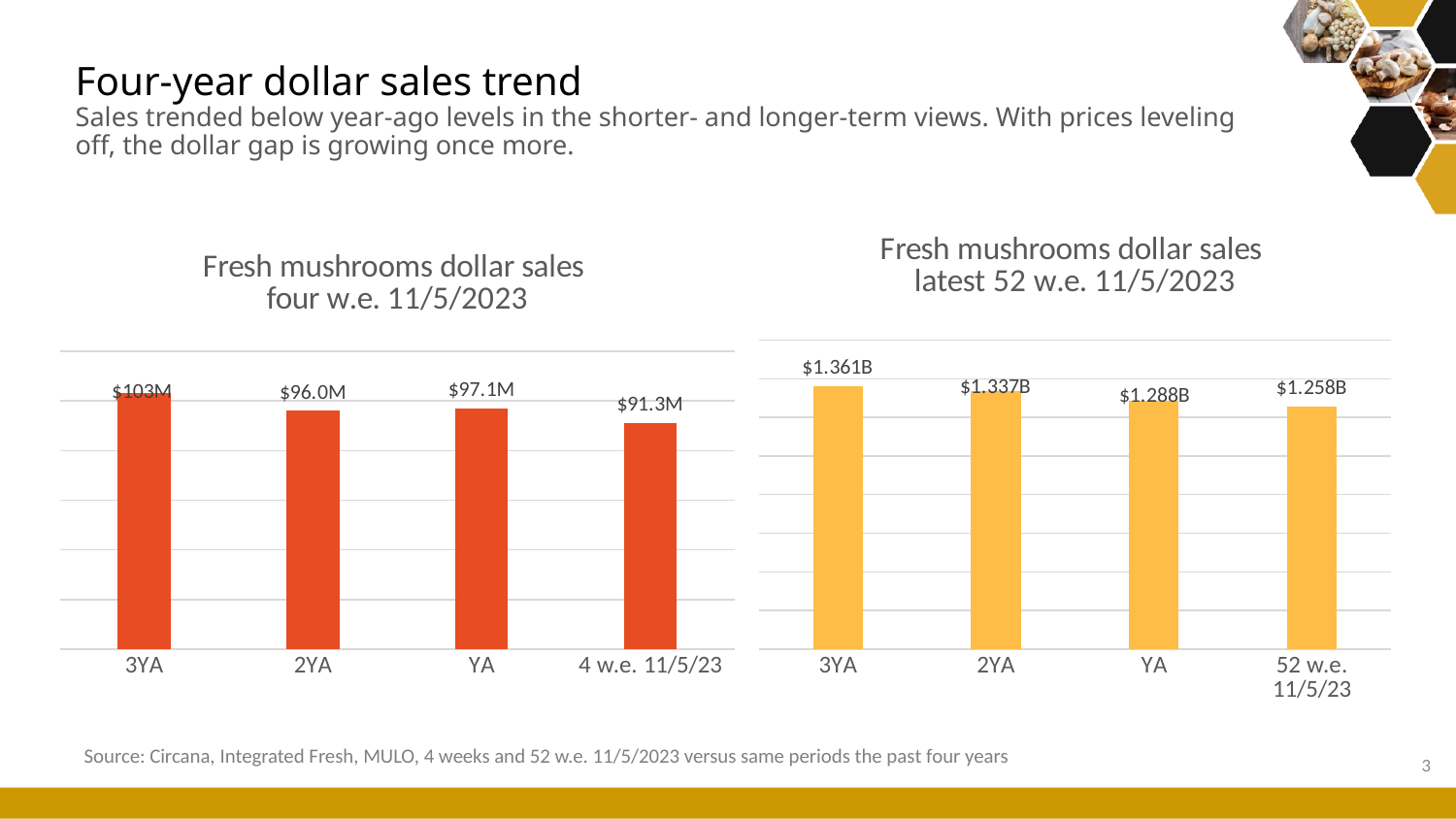
In the 'Fresh mushrooms dollar sales latest 52 w.e. 11/5/2023' chart, what is the value for YA? $1.288B What type of chart is the 'Fresh mushrooms dollar sales latest 52 w.e. 11/5/2023' chart? bar chart In the 'Fresh mushrooms dollar sales four w.e. 11/5/2023' chart, which is larger, the value for 2YA or the value for YA? YA In the 'Fresh mushrooms dollar sales latest 52 w.e. 11/5/2023' chart, do the values rise or fall from 3YA to 52 w.e. 11/5/23? fall How many bars are in the 'Fresh mushrooms dollar sales four w.e. 11/5/2023' chart? 4 In the 'Fresh mushrooms dollar sales four w.e. 11/5/2023' chart, what is the value for 3YA? $103M In the 'Fresh mushrooms dollar sales latest 52 w.e. 11/5/2023' chart, which period has the lowest value? 52 w.e. 11/5/23 In the 'Fresh mushrooms dollar sales latest 52 w.e. 11/5/2023' chart, what is the value for 52 w.e. 11/5/23? $1.258B In the 'Fresh mushrooms dollar sales four w.e. 11/5/2023' chart, which period has the highest value? 3YA In the 'Fresh mushrooms dollar sales four w.e. 11/5/2023' chart, which period has the lowest value? 4 w.e. 11/5/23 In the 'Fresh mushrooms dollar sales latest 52 w.e. 11/5/2023' chart, what is the difference between the 3YA value and the 52 w.e. 11/5/23 value? $0.103B In the 'Fresh mushrooms dollar sales four w.e. 11/5/2023' chart, what is the value for 4 w.e. 11/5/23? $91.3M